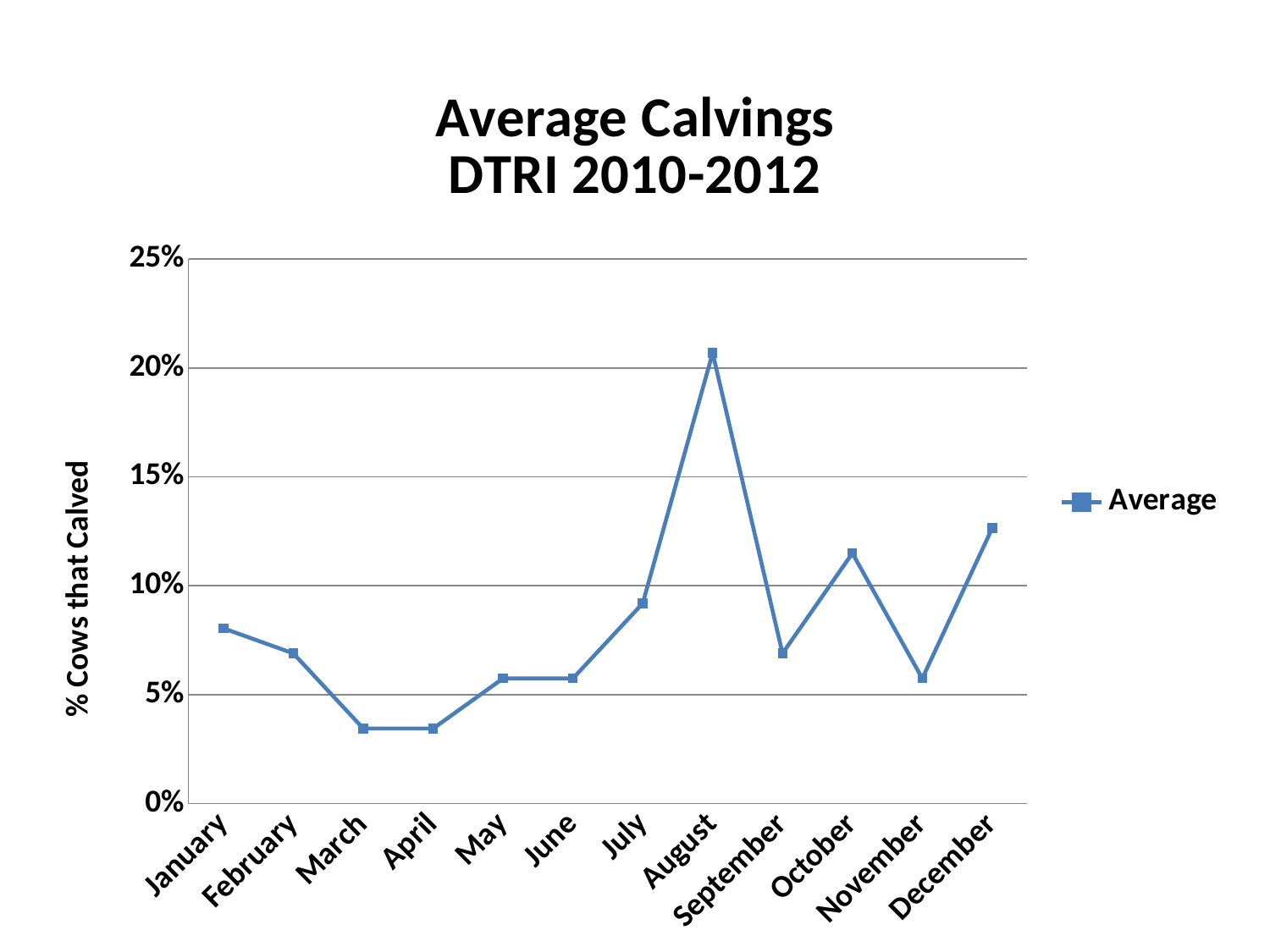
Which is larger, the value for October or the value for September? October Is the value for October greater or less than 10%? greater Is the value for August greater or less than 20%? greater Is the value for January greater or less than 10%? less Which is larger, the value for December or the value for January? December Do the values rise or fall from January to March? fall What is the title of the chart? Average Calvings DTRI 2010-2012 How many months are plotted on the x axis? 12 How many series does the legend list? 1 Which month has the highest average calving percentage? August What kind of chart is shown on the slide? line chart